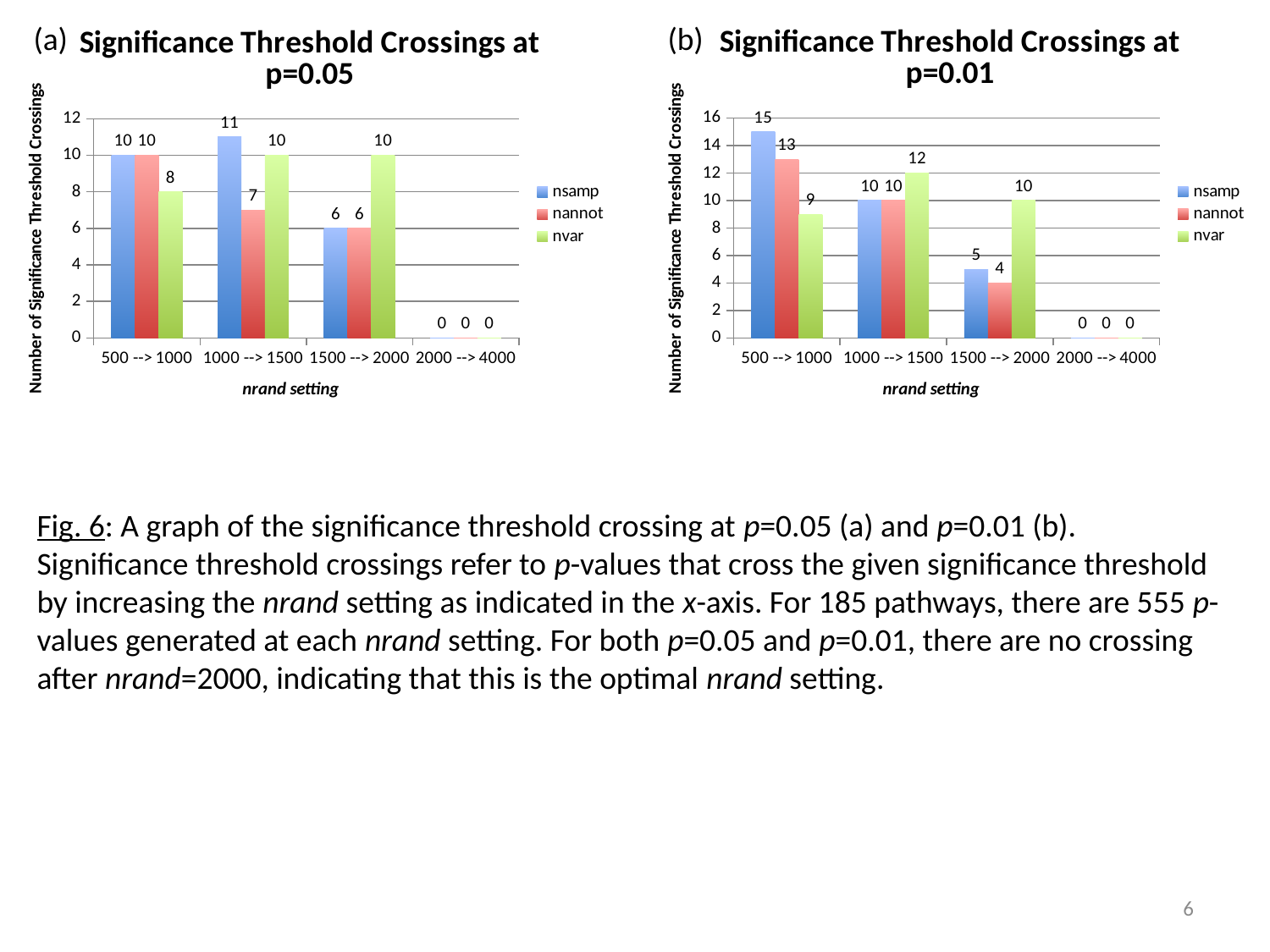
In the chart 'Significance Threshold Crossings at p=0.05', what is the value of nsamp for the 1000 --> 1500 setting? 11 How many series does the legend of the chart 'Significance Threshold Crossings at p=0.05' list? 3 In the chart 'Significance Threshold Crossings at p=0.01', what is the value of nvar for the 1000 --> 1500 setting? 12 What kind of chart is 'Significance Threshold Crossings at p=0.01'? Bar chart In the chart 'Significance Threshold Crossings at p=0.01', what is the difference between nsamp and nannot for the 1500 --> 2000 setting? 1 How many nrand settings are shown on the x axis of the chart 'Significance Threshold Crossings at p=0.01'? 4 In the chart 'Significance Threshold Crossings at p=0.05', which nrand setting has the lowest nvar value? 2000 --> 4000 In the chart 'Significance Threshold Crossings at p=0.05', which is larger for the 1000 --> 1500 setting, nannot or nvar? nvar In the chart 'Significance Threshold Crossings at p=0.05', what is the value of nvar for the 500 --> 1000 setting? 8 In the chart 'Significance Threshold Crossings at p=0.01', what is the value of nannot for the 500 --> 1000 setting? 13 In the chart 'Significance Threshold Crossings at p=0.01', which nrand setting has the highest nsamp value? 500 --> 1000 In the chart 'Significance Threshold Crossings at p=0.01', does the nannot value rise or fall across the nrand settings from left to right? Fall